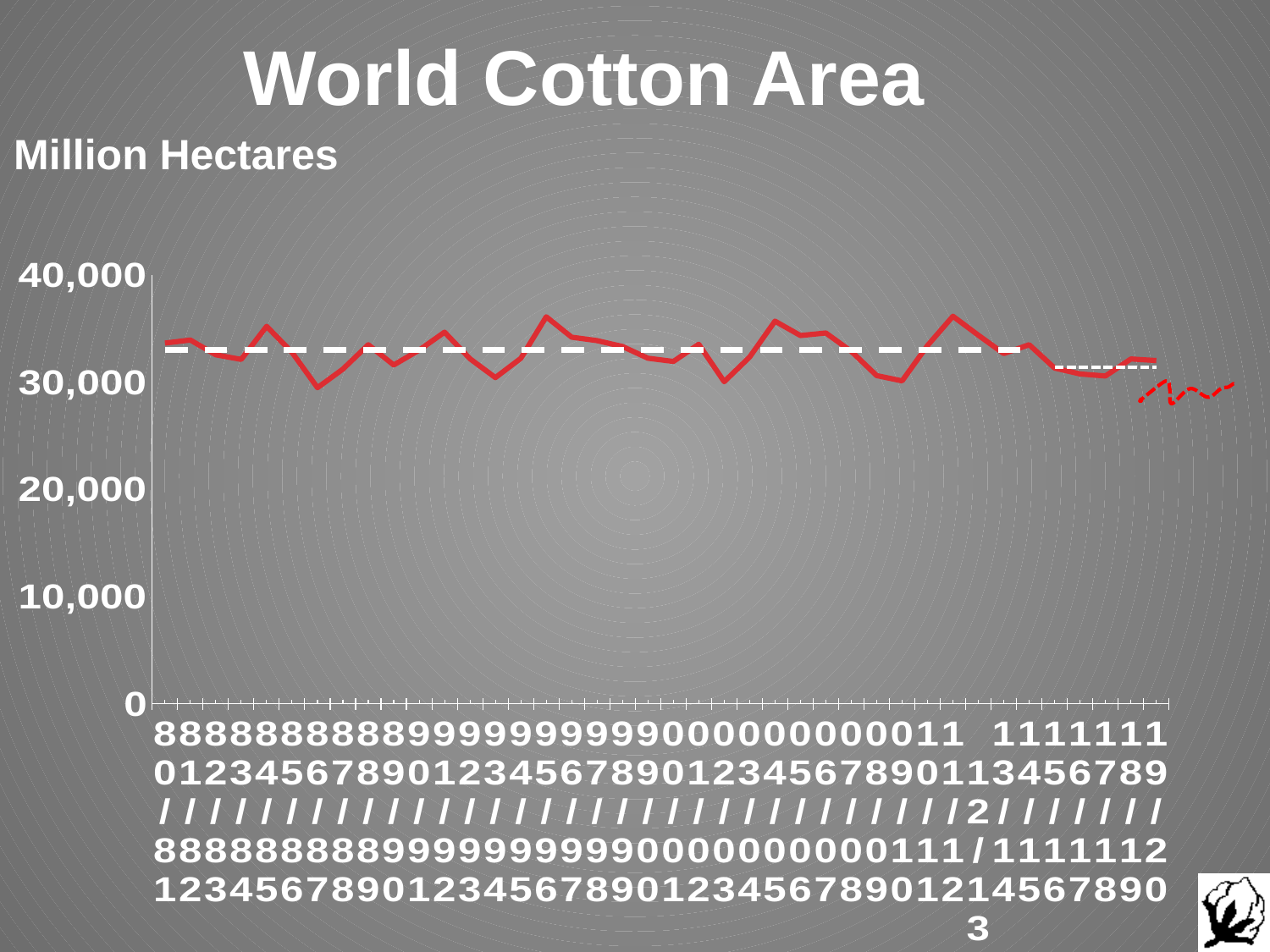
Does the line ever drop below 20,000? No What is the highest value labelled on the vertical axis? 40,000 What is the title of the chart? World Cotton Area What kind of chart is shown on the slide? line chart Is the highest value on the line greater or less than 40,000? less Is the value for 80/81 greater or less than 30,000? greater In what unit are the values on the chart expressed? Million Hectares